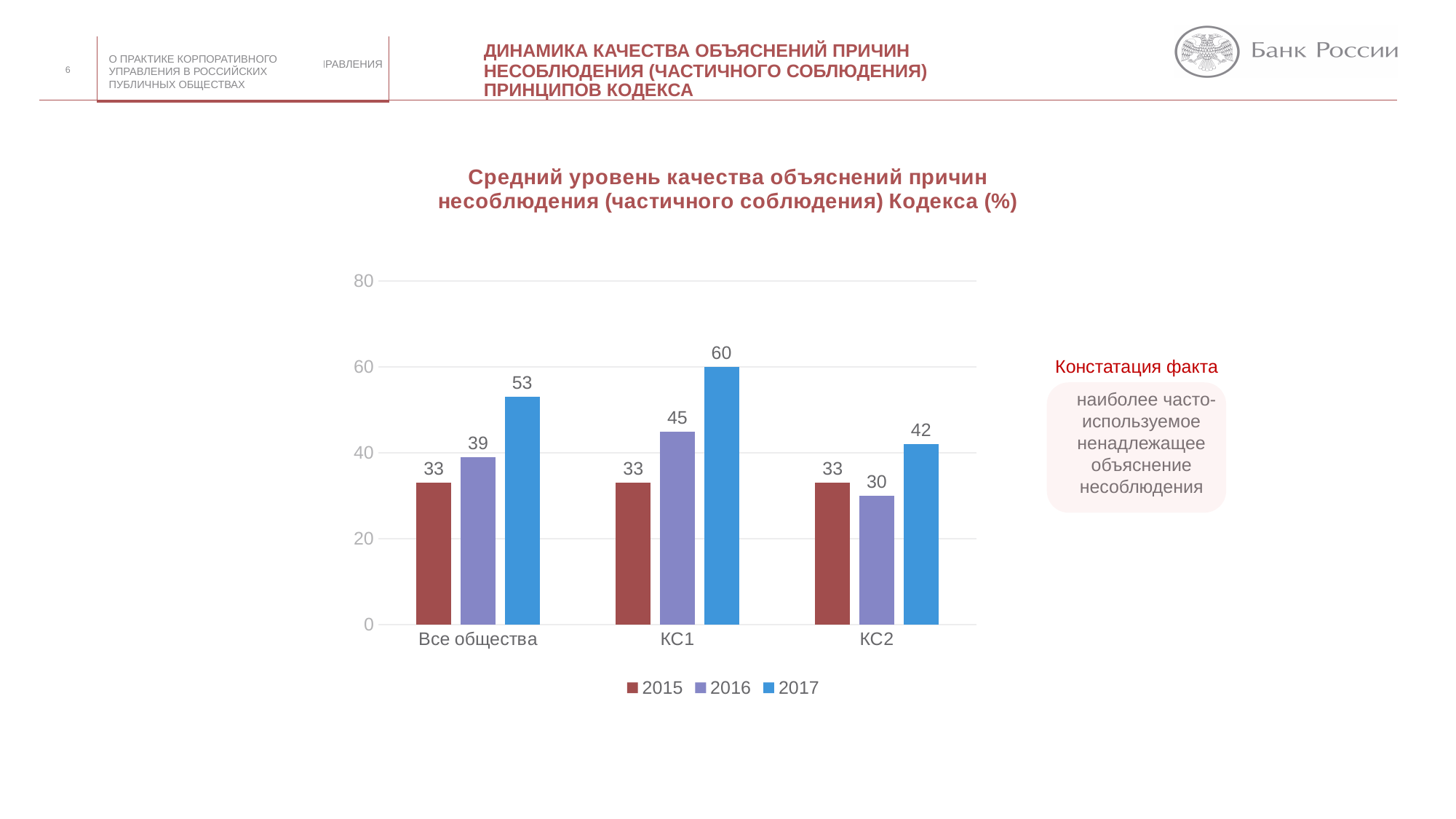
What is the value for КС2 in 2016? 30 How many categories are shown on the x axis? 3 What is the value for Все общества in 2016? 39 Which is larger: the 2016 value for КС1 or the 2016 value for КС2? КС1 What kind of chart is shown on the slide? bar chart Which category has the lowest value in 2016? КС2 What is the difference between the 2017 and 2015 values for Все общества? 20 What is the value for КС1 in 2017? 60 Is the value for КС2 in 2017 greater or less than 40? greater How many series does the legend list? 3 Which category has the highest value in 2017? КС1 Which series is shown in blue in the legend? 2017